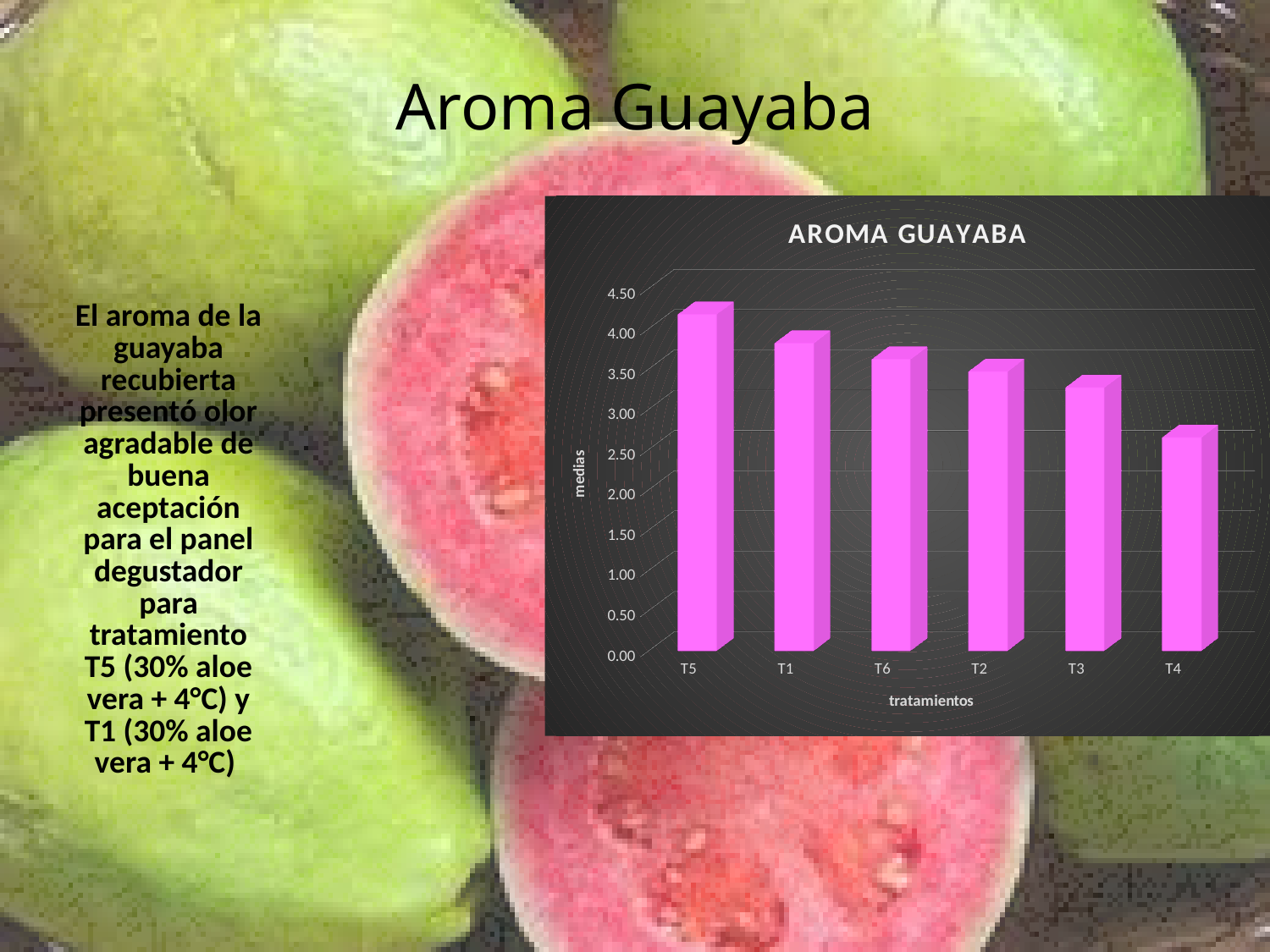
What is the label of the vertical axis? medias Is the value for T3 greater or less than 3.00? greater Is the value for T4 greater or less than 3.00? less Do the values rise or fall from left to right along the x axis? fall What kind of chart is shown on the slide? bar chart What is the title of the chart? AROMA GUAYABA Which treatment has the lowest value? T4 Which is larger, the value for T1 or the value for T3? T1 How many treatments (categories) are plotted on the x axis? 6 Is the value for T2 greater or less than 3.00? greater Which treatment has the highest value? T5